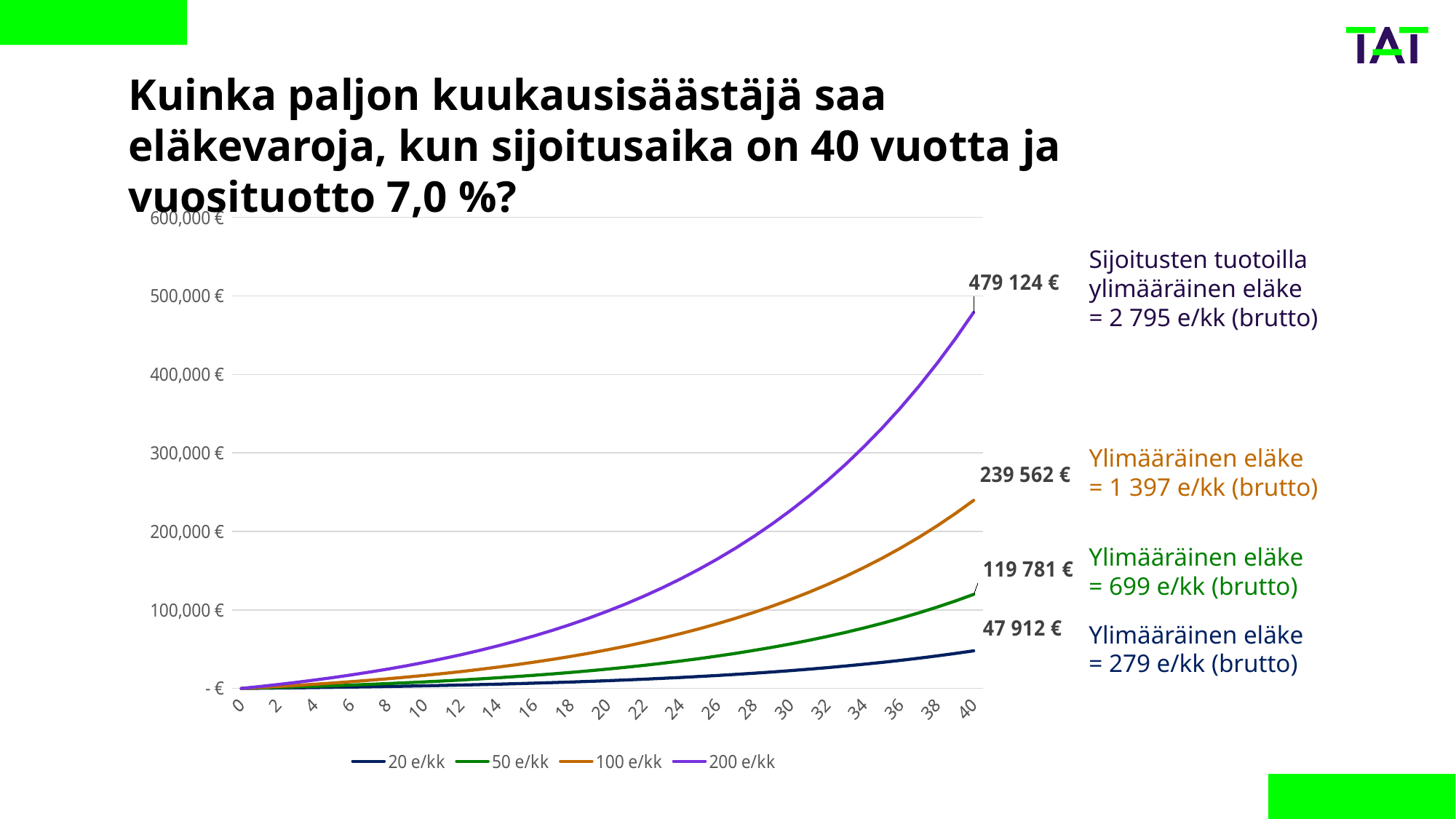
What is the difference between the 200 e/kk and 100 e/kk values at year 40? 239 562 € What is the value of the 20 e/kk series at year 40? 47 912 € Which is larger at year 40: the 100 e/kk series or the 50 e/kk series? 100 e/kk What kind of chart is shown on the slide? line chart What is the value of the 100 e/kk series at year 40? 239 562 € Which series has the lowest value at year 40? 20 e/kk What is the value of the 50 e/kk series at year 40? 119 781 € How many series does the legend list? 4 Which series has the highest value at year 40? 200 e/kk What is the value of the 200 e/kk series at year 40? 479 124 € Is the value of the 100 e/kk series at year 20 greater or less than 100,000 €? less Do the values of the 200 e/kk series rise or fall as the years increase along the x axis? rise